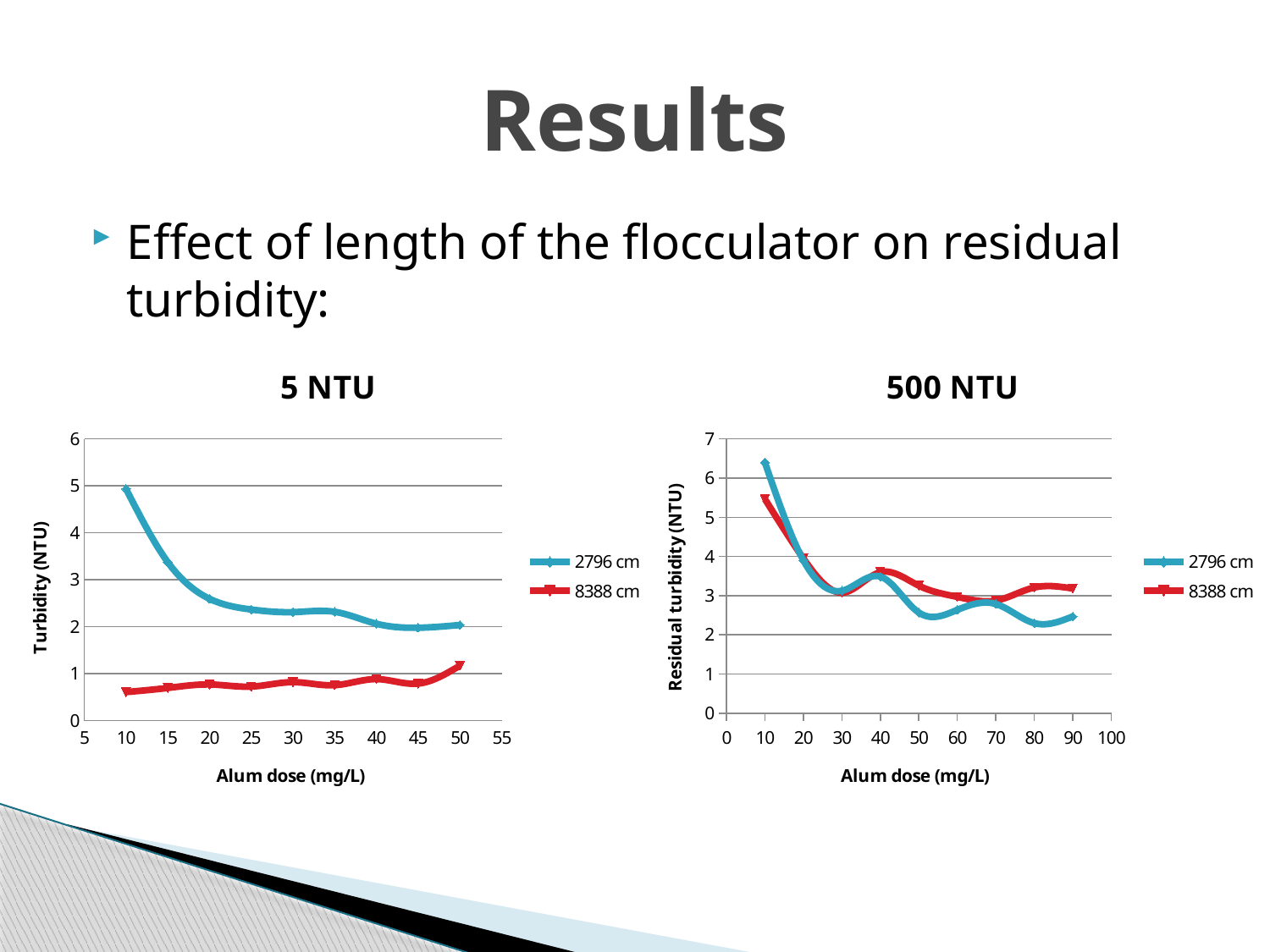
In the 500 NTU chart, which series has the higher residual turbidity at an alum dose of 80 mg/L, 2796 cm or 8388 cm? 8388 cm In the 500 NTU chart, is the residual turbidity for 2796 cm at an alum dose of 80 mg/L greater or less than 3? less In the 500 NTU chart, how many data points does the 8388 cm series have? 9 What kind of chart is the 5 NTU chart? line chart In the 5 NTU chart, how many data points does the 2796 cm series have? 9 How many series does the legend of the 500 NTU chart list? 2 What is the x-axis label of the 500 NTU chart? Alum dose (mg/L) In the 5 NTU chart, does the turbidity for the 2796 cm series generally rise or fall as the alum dose increases? fall In the 5 NTU chart, which series has the higher turbidity at an alum dose of 30 mg/L, 2796 cm or 8388 cm? 2796 cm In the 5 NTU chart, is the turbidity for 8388 cm at an alum dose of 10 mg/L greater or less than 1? less In the 500 NTU chart, is the residual turbidity for 2796 cm at an alum dose of 10 mg/L greater or less than 6? greater